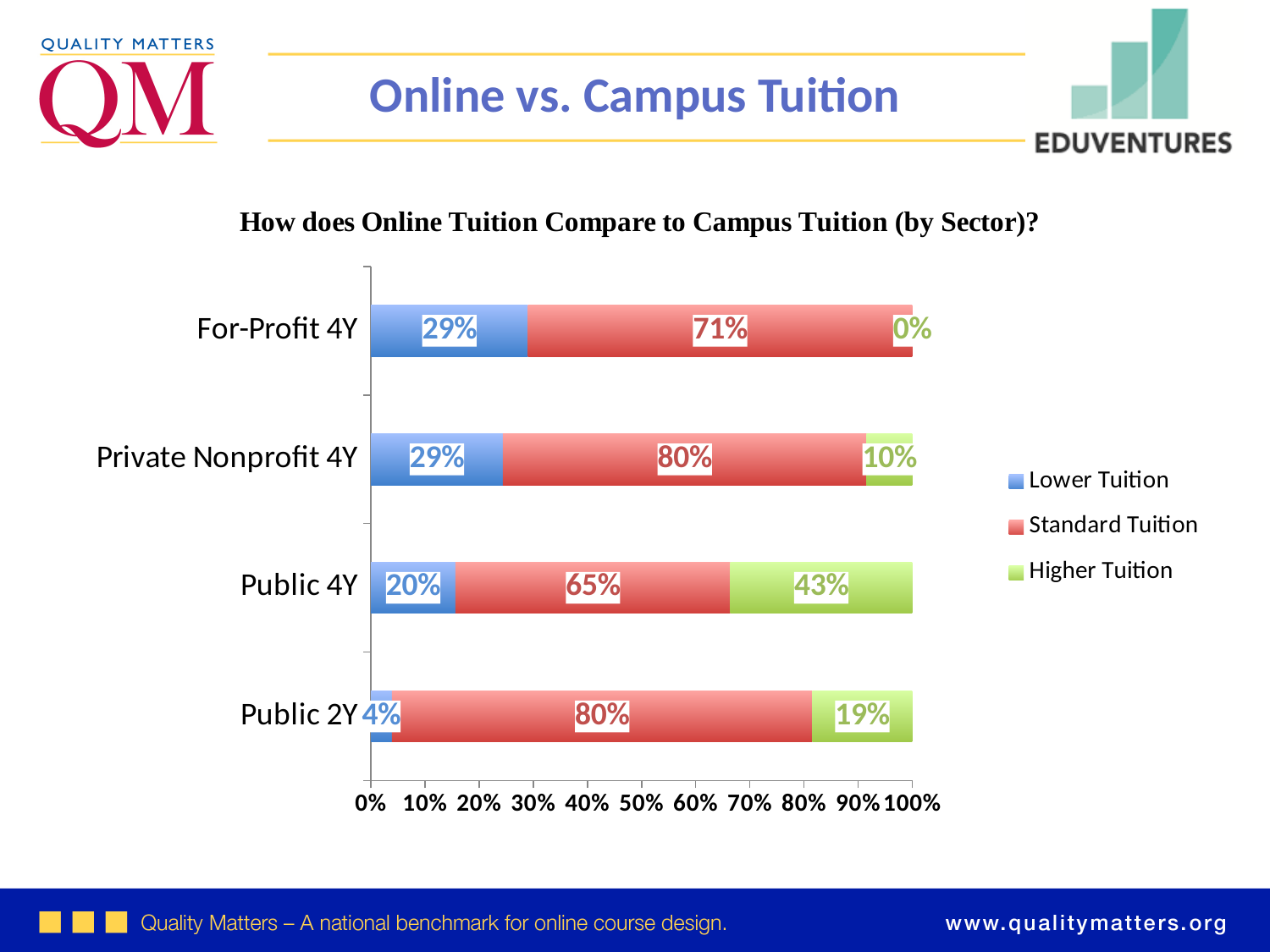
What is the Standard Tuition value for Public 4Y? 65% What is the title of the chart? How does Online Tuition Compare to Campus Tuition (by Sector)? What is the difference between the Higher Tuition values for Public 4Y and Public 2Y? 24% What is the Lower Tuition value for Public 2Y? 4% Which sector has the highest Higher Tuition value? Public 4Y Which sector has the lowest Lower Tuition value? Public 2Y What is the Higher Tuition value for Private Nonprofit 4Y? 10% How many series does the legend list? 3 Which is larger, the Standard Tuition value for For-Profit 4Y or for Private Nonprofit 4Y? Private Nonprofit 4Y How many sectors (categories) are shown on the chart? 4 What is the Higher Tuition value for For-Profit 4Y? 0% What kind of chart is shown on the slide? Stacked bar chart